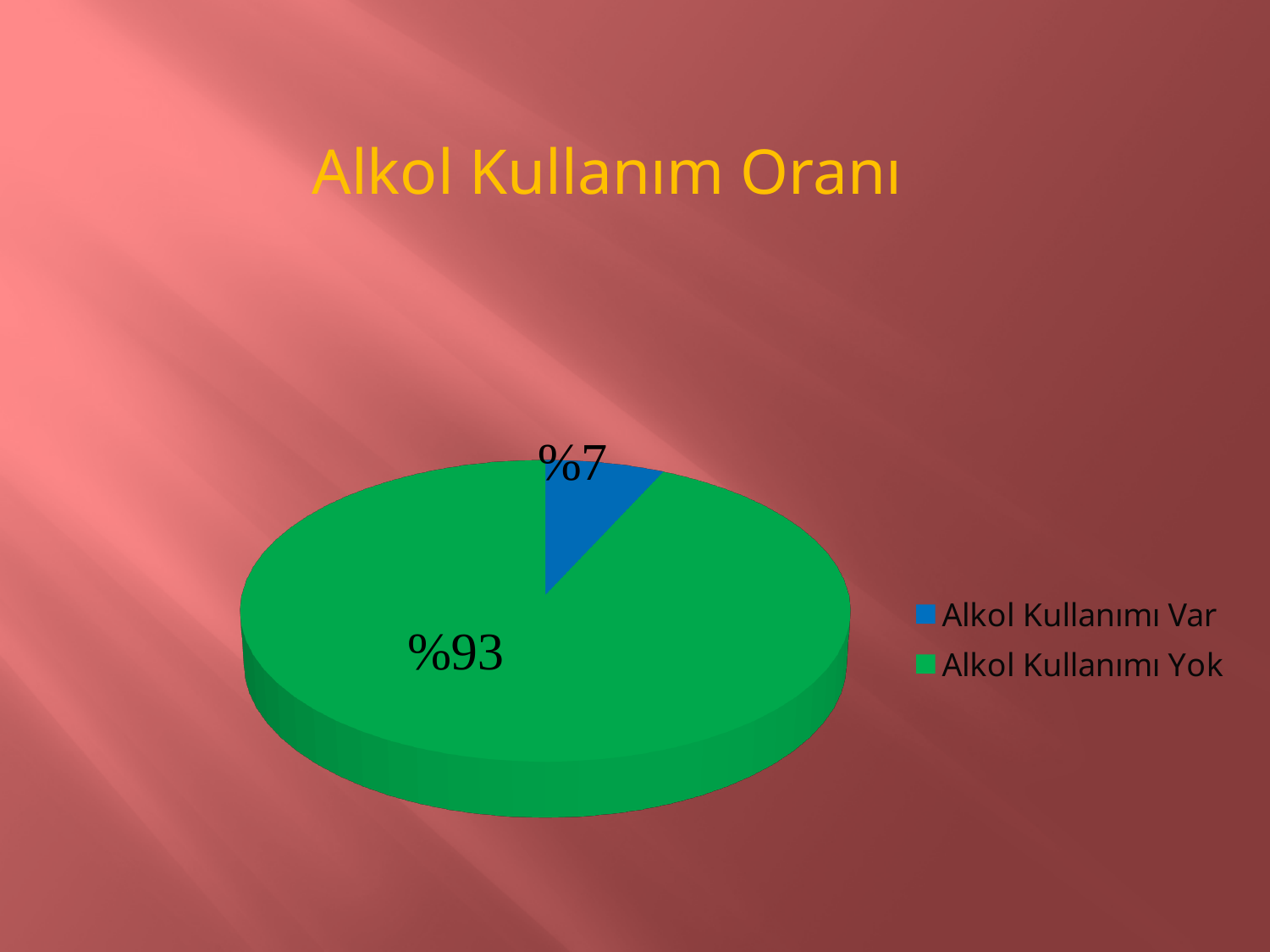
What value is shown for Alkol Kullanımı Var? %7 Which category has the largest slice of the pie? Alkol Kullanımı Yok What is the difference between the values for Alkol Kullanımı Yok and Alkol Kullanımı Var? %86 How many slices does the pie chart have? 2 What is the title of the chart? Alkol Kullanım Oranı What value is shown for Alkol Kullanımı Yok? %93 What share of the pie does Alkol Kullanımı Yok represent? %93 Which is larger: Alkol Kullanımı Var or Alkol Kullanımı Yok? Alkol Kullanımı Yok Which category has the smallest slice of the pie? Alkol Kullanımı Var What type of chart is shown on the slide? Pie chart What colour is the slice for Alkol Kullanımı Var? Blue How many entries does the legend list? 2